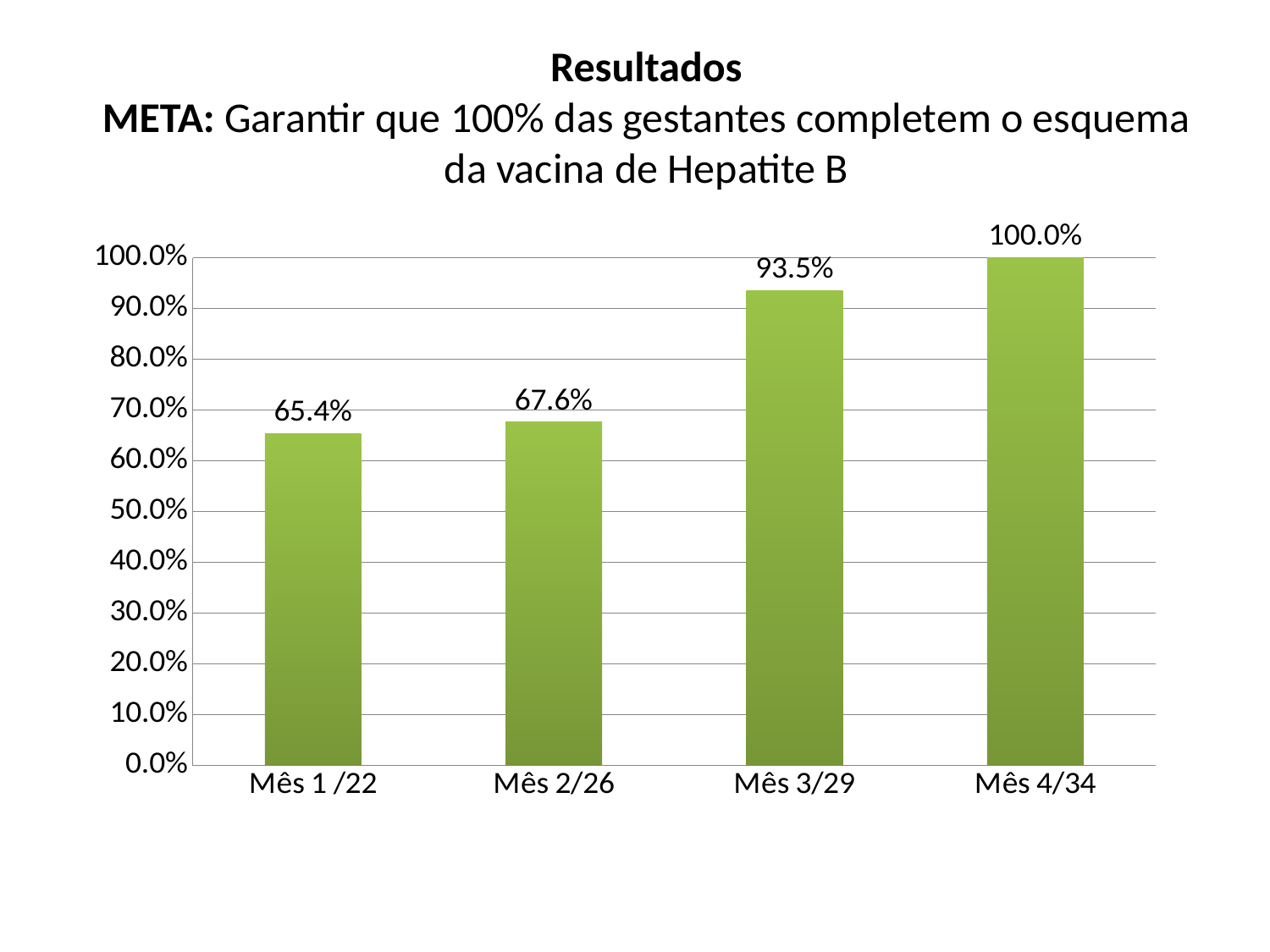
What kind of chart is shown on the slide? Bar chart What is the value for Mês 2/26? 67.6% Do the values rise or fall from Mês 1 /22 to Mês 4/34? Rise Which category has the lowest value? Mês 1 /22 How many categories are shown on the x axis? 4 What is the difference between the values for Mês 2/26 and Mês 1 /22? 2.2% What is the difference between the values for Mês 4/34 and Mês 3/29? 6.5% Which is larger, the value for Mês 3/29 or the value for Mês 2/26? Mês 3/29 What is the value for Mês 4/34? 100.0% What is the value for Mês 1 /22? 65.4% What is the value for Mês 3/29? 93.5% Which category has the highest value? Mês 4/34